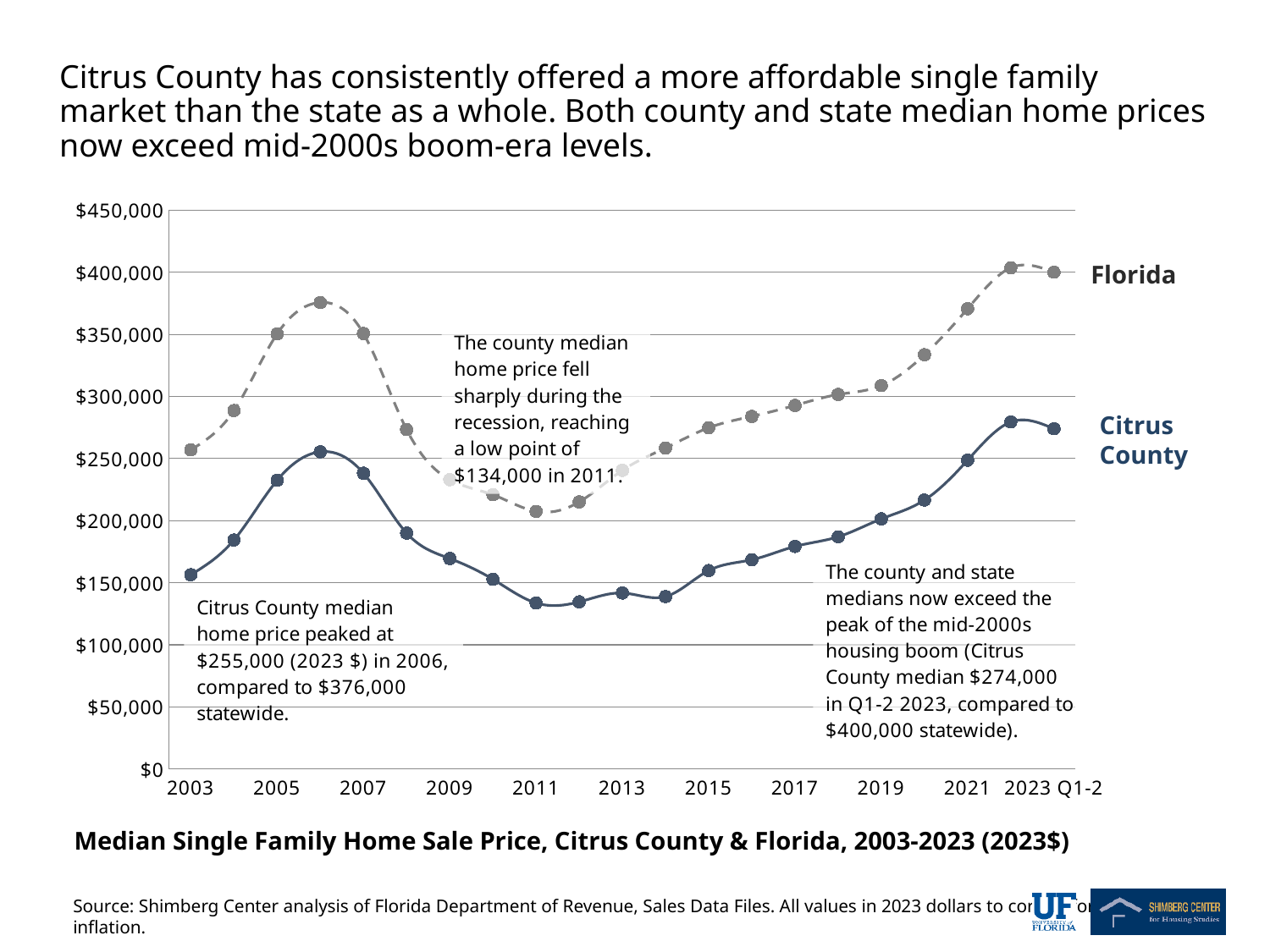
What is the difference between the Florida and Citrus County medians in 2006? $121,000 How many series are plotted on the chart? 2 What was the Florida statewide median home price in 2006? $376,000 What is the Florida statewide median home price in Q1-2 2023? $400,000 What was the Citrus County median home price at its 2006 peak? $255,000 Which series has the higher median home price in 2006, Florida or Citrus County? Florida What is the Citrus County median home price in Q1-2 2023? $274,000 What kind of chart is shown on the slide? Line chart Is the Florida value for 2021 greater or less than $350,000? greater What is the difference between the Florida and Citrus County medians in Q1-2 2023? $126,000 What was the low point of the Citrus County median home price in 2011? $134,000 In which year did the Citrus County median home price reach its lowest point? 2011